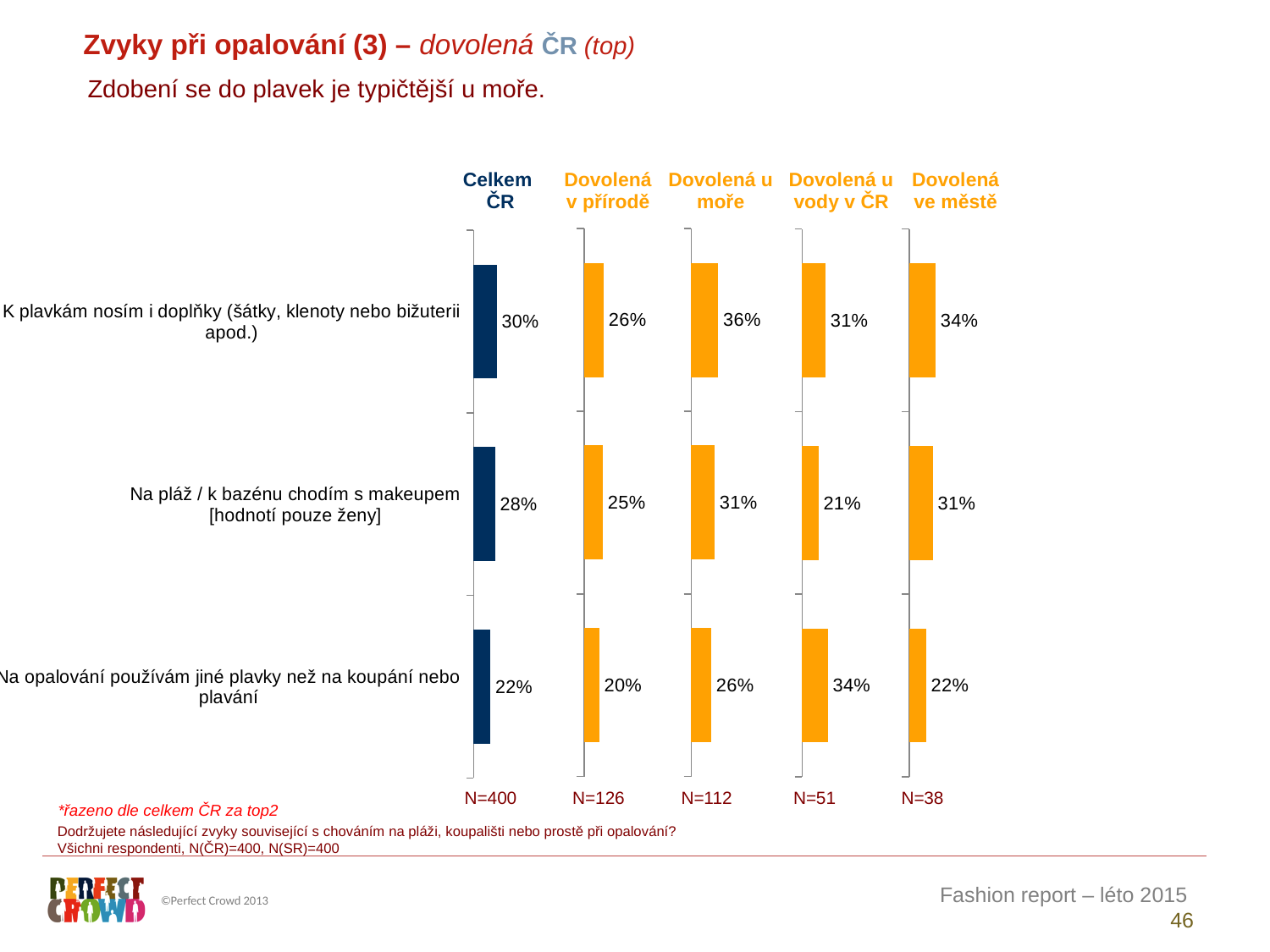
For 'Na pláž / k bazénu chodím s makeupem', which is larger: the value in the 'Dovolená u moře' chart or the value in the 'Dovolená u vody v ČR' chart? Dovolená u moře In the 'Dovolená u moře' chart, what is the difference between the value for 'K plavkám nosím i doplňky' and the value for 'Na opalování používám jiné plavky než na koupání nebo plavání'? 10% What kind of chart is the 'Celkem ČR' chart? Bar chart How many categories are shown in the 'Celkem ČR' chart? 3 In the 'Dovolená ve městě' chart, which category has the highest value? K plavkám nosím i doplňky (šátky, klenoty nebo bižuterii apod.) In the 'Dovolená u vody v ČR' chart, which category has the lowest value? Na pláž / k bazénu chodím s makeupem [hodnotí pouze ženy] How many separate charts (columns of bars) are shown on the slide? 5 In the 'Dovolená u moře' chart, what is the value for 'Na pláž / k bazénu chodím s makeupem [hodnotí pouze ženy]'? 31% In the 'Dovolená u vody v ČR' chart, what is the value for 'Na opalování používám jiné plavky než na koupání nebo plavání'? 34% In the 'Dovolená v přírodě' chart, what is the value for 'Na opalování používám jiné plavky než na koupání nebo plavání'? 20% In the 'Celkem ČR' chart, what is the value for 'K plavkám nosím i doplňky (šátky, klenoty nebo bižuterii apod.)'? 30% What sample size (N) is shown under the 'Dovolená ve městě' chart? N=38